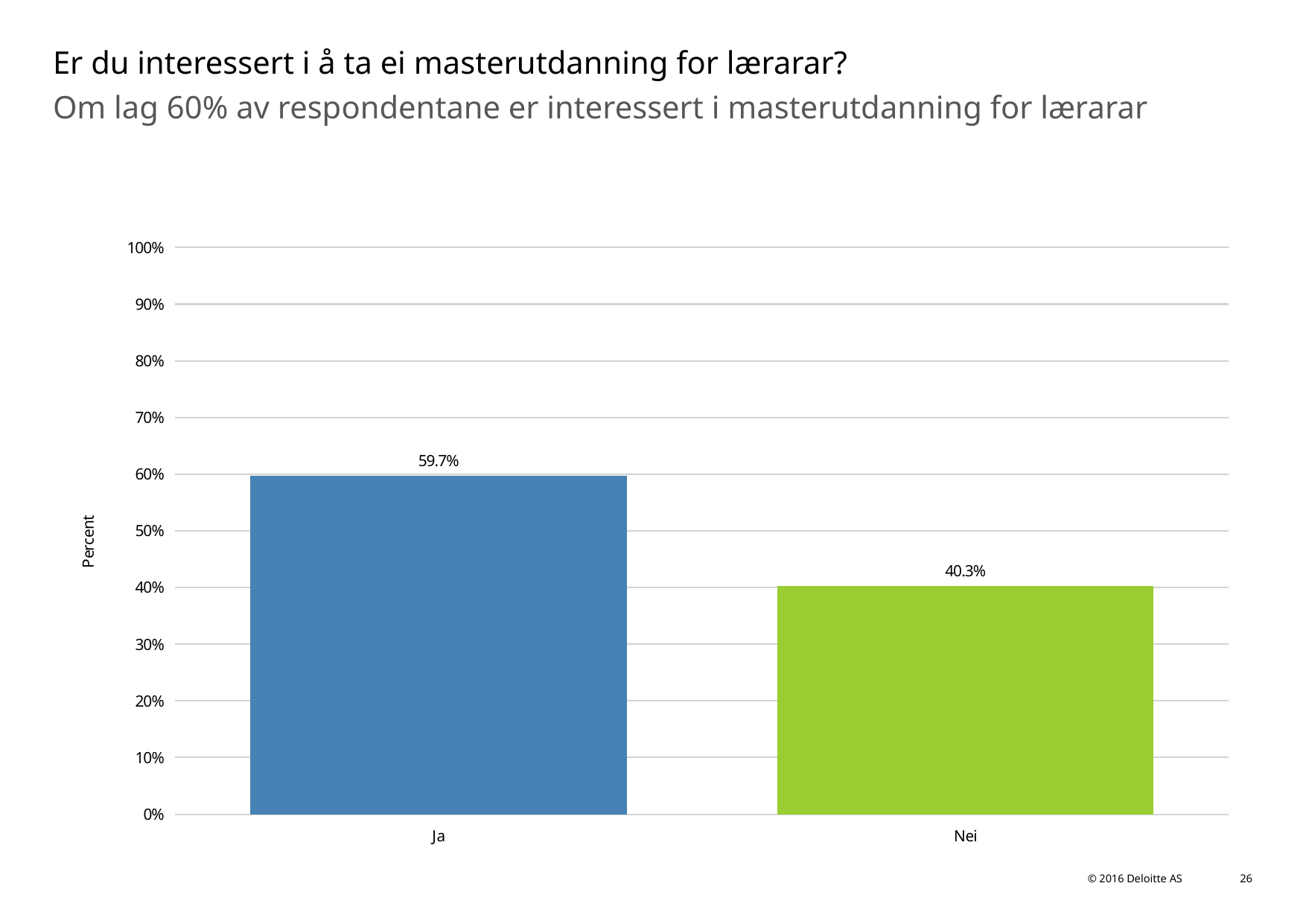
Which is larger, the value for Ja or the value for Nei? Ja What colour is the bar for Nei? green What is the difference between the values for Ja and Nei? 19.4% Is the value for Nei greater or less than 50%? less What is the value for Ja? 59.7% What is the value for Nei? 40.3% Which category has the lowest value? Nei What is the label of the y axis? Percent How many categories are shown on the x axis? 2 Is the value for Ja greater or less than 50%? greater What kind of chart is shown on the slide? bar chart Which category has the highest value? Ja